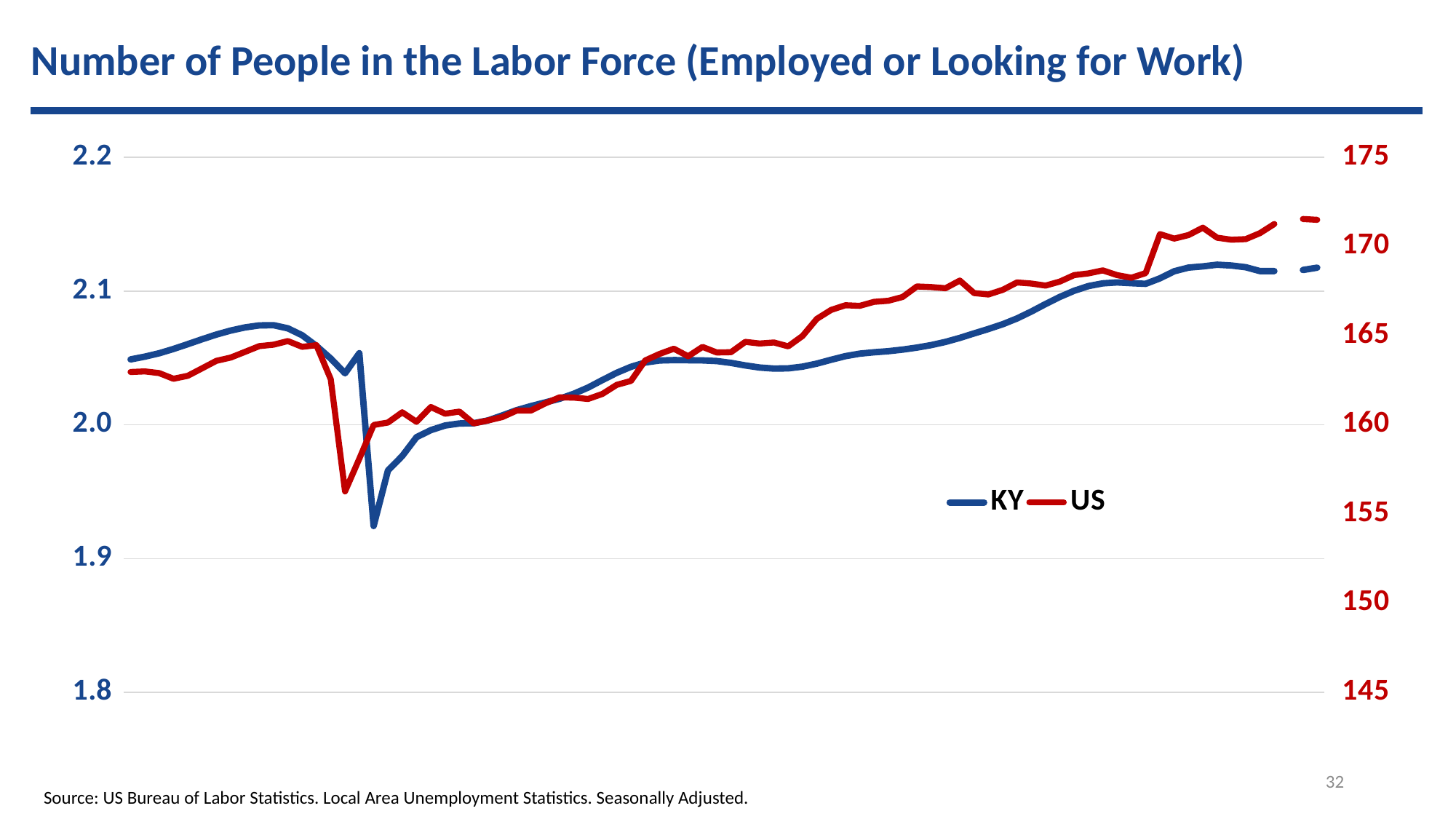
Is the lowest point of the KY line greater or less than 1.9 on the left axis? greater How many series does the legend list? 2 Over the whole period, does the US line generally rise or fall from left to right? rise Over the whole period, does the KY line generally rise or fall from left to right? rise Is the value of the KY line at the left end of the chart greater or less than 2.0 on the left axis? greater Is the lowest point of the US line greater or less than 160 on the right axis? less Which axis, left or right, is the US series plotted against? right What kind of chart is shown on the slide? line chart What are the two series named in the legend? KY and US